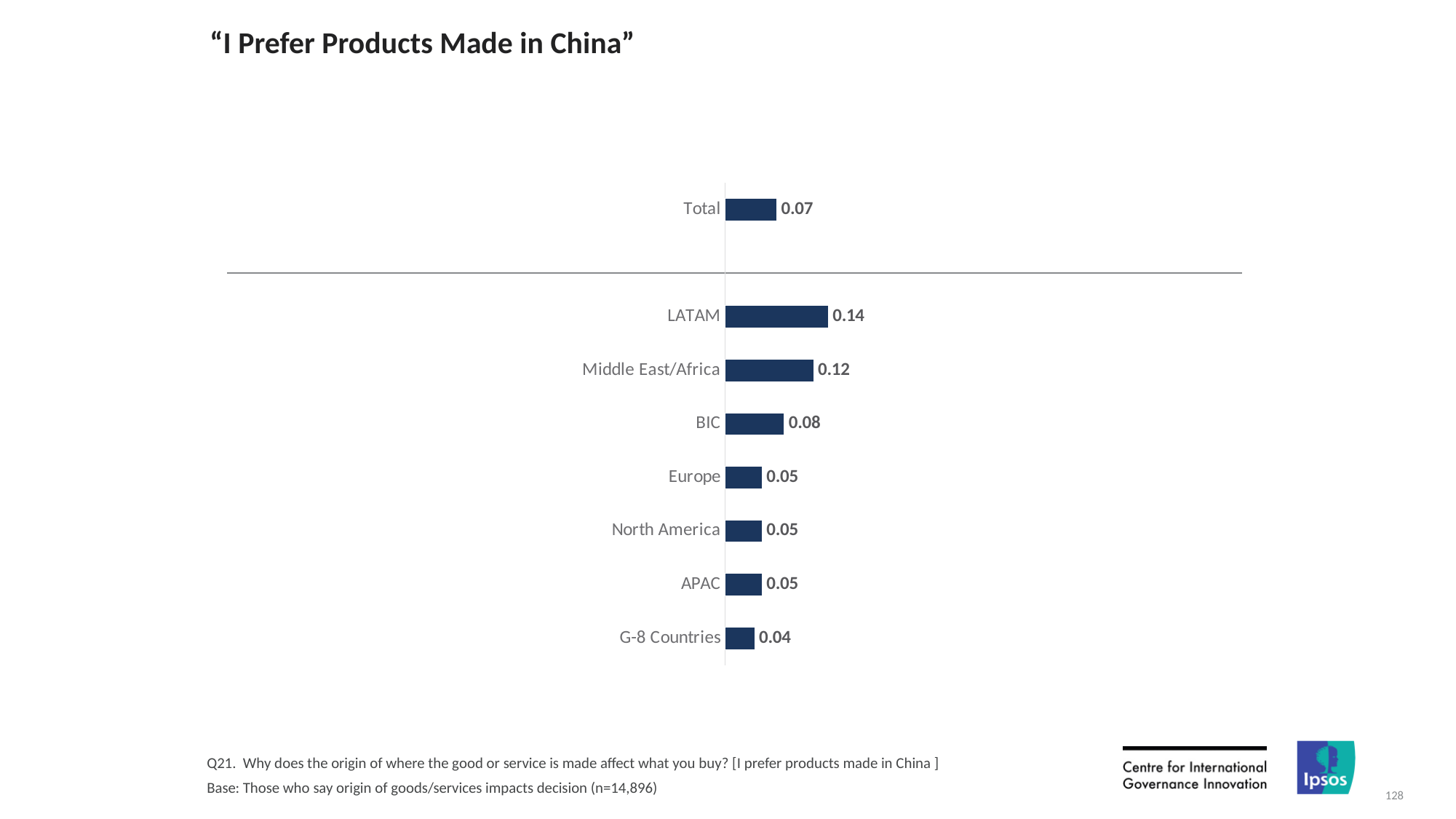
What is the value for Middle East/Africa? 0.12 What is the title of the chart? "I Prefer Products Made in China" What is the value for Total? 0.07 What is the value for LATAM? 0.14 Which category has the lowest value? G-8 Countries What kind of chart is shown on the slide? Bar chart Which region has the highest value? LATAM Which is larger, the value for BIC or the value for Europe? BIC What is the difference between the values for LATAM and Middle East/Africa? 0.02 What is the value for G-8 Countries? 0.04 How many categories are shown in the chart, including Total? 8 What is the difference between the values for BIC and G-8 Countries? 0.04